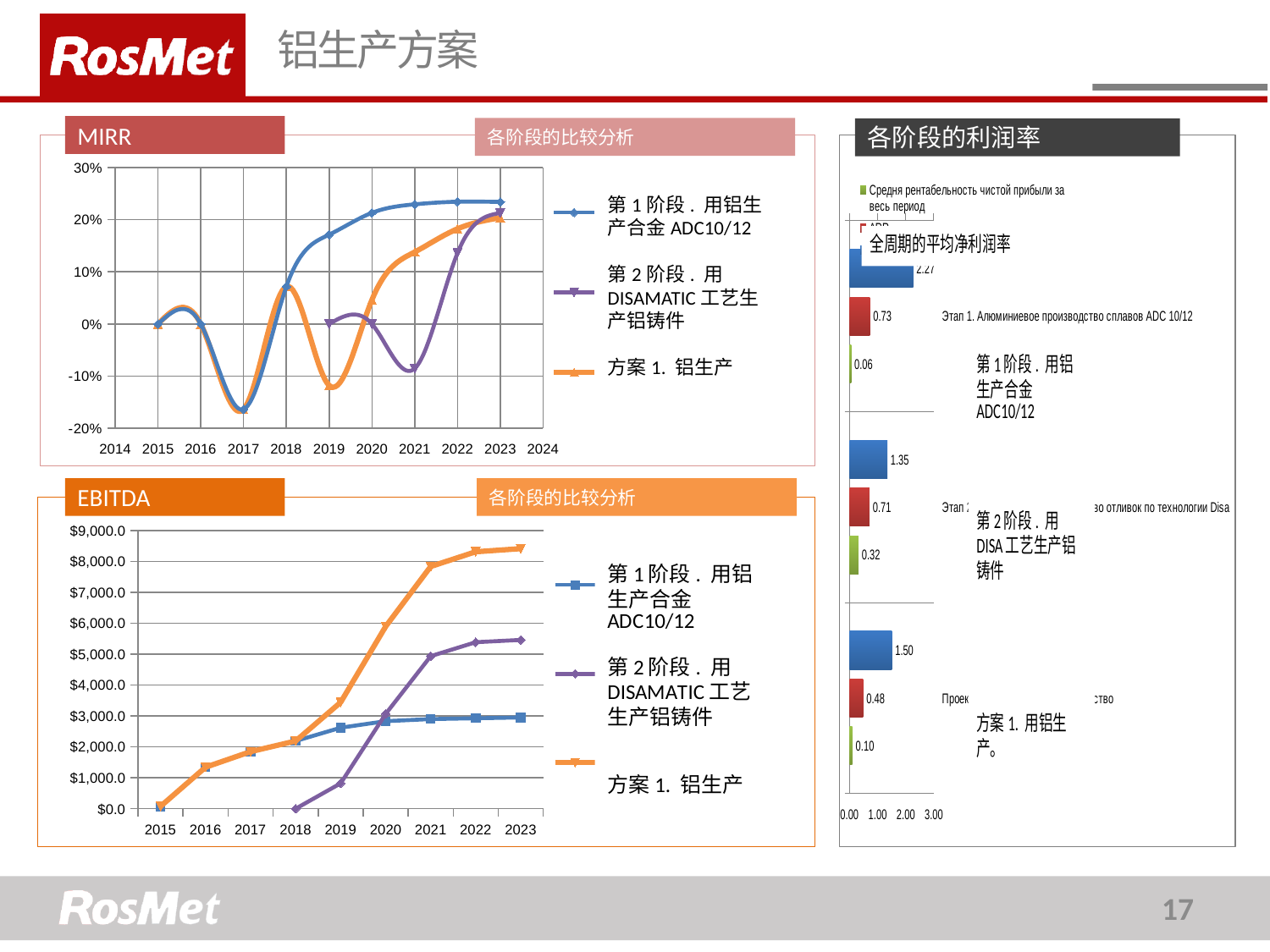
In the EBITDA chart, is the value for 第 2 阶段 in 2023 greater or less than $5,000.0? greater In the MIRR chart, is the value for 第 1 阶段 in 2023 greater or less than 20%? greater In the MIRR chart, is the value for 第 1 阶段 in 2017 greater or less than -10%? less How many series does the legend of the EBITDA chart list? 3 What type of chart is the MIRR chart? line chart How many years are shown on the x axis of the EBITDA chart? 9 In the right-hand chart (各阶段的利润率), what is the difference between the blue bar for 第 1 阶段 (2.27) and the blue bar for 方案 1 (1.50)? 0.77 In the right-hand chart (各阶段的利润率), what is the value of the blue bar for 第 1 阶段? 2.27 How many series does the legend of the MIRR chart list? 3 In the EBITDA chart, which series has the highest value in 2023? 方案 1. 铝生产